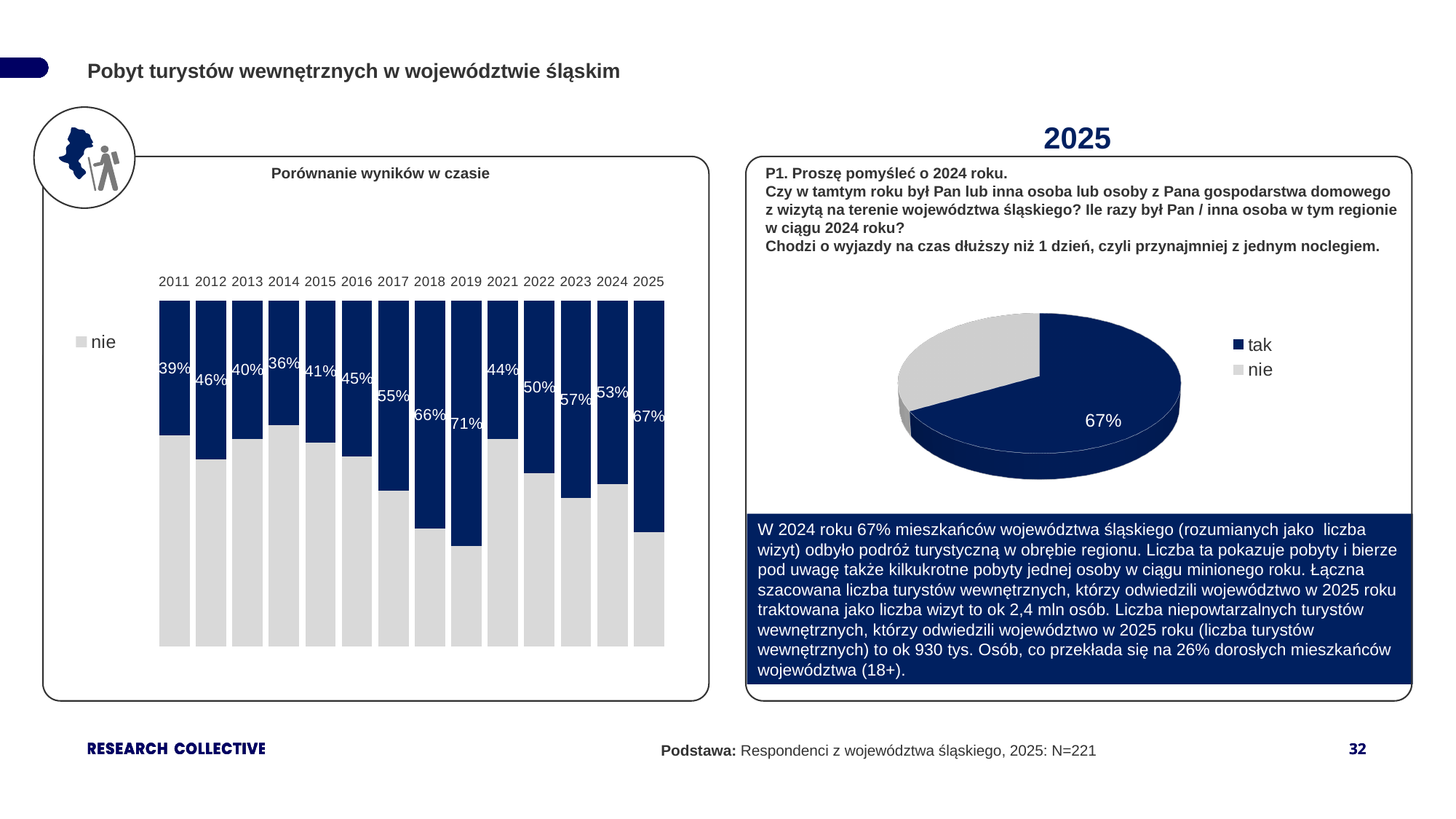
In the 'Porównanie wyników w czasie' chart, what is the labelled value for 2019? 71% What kind of chart is the 'Porównanie wyników w czasie' chart on the left? Stacked bar chart In the 'Porównanie wyników w czasie' chart, which year has the highest labelled value? 2019 In the pie chart for 2025 on the right, what share is labelled for 'tak'? 67% How many entries does the legend of the pie chart on the right list? 2 What kind of chart is shown on the right side of the slide under the heading 2025? Pie chart In the 'Porównanie wyników w czasie' chart, what is the labelled value for 2011? 39% In the 'Porównanie wyników w czasie' chart, which year has the lowest labelled value? 2014 In the 'Porównanie wyników w czasie' chart, which year has the larger labelled value, 2018 or 2021? 2018 In the 'Porównanie wyników w czasie' chart, what is the difference between the labelled values for 2025 and 2024? 14 percentage points In the 'Porównanie wyników w czasie' chart, what is the labelled value for 2025? 67% How many years (bars) are shown in the 'Porównanie wyników w czasie' chart? 14